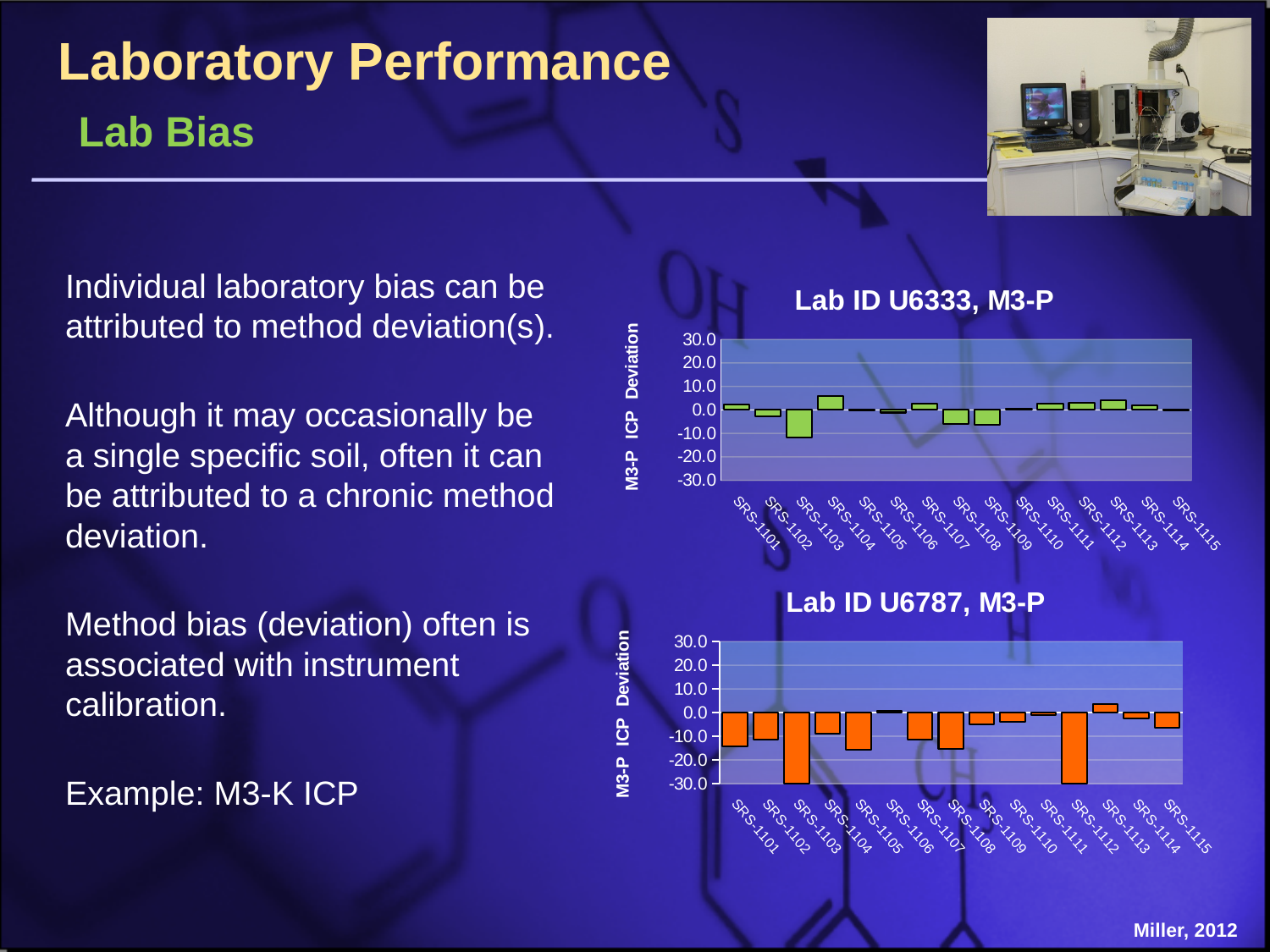
What colour are the bars in the 'Lab ID U6787, M3-P' chart? orange In the 'Lab ID U6787, M3-P' chart, is the value for SRS-1101 greater or less than 0.0? less How many categories (SRS samples) are shown on the x axis of the 'Lab ID U6787, M3-P' chart? 15 In the 'Lab ID U6333, M3-P' chart, which category has the lowest value? SRS-1103 In the 'Lab ID U6787, M3-P' chart, which category has the highest value? SRS-1113 In the 'Lab ID U6333, M3-P' chart, is the value for SRS-1104 greater or less than 0.0? greater What is the y-axis label on the 'Lab ID U6333, M3-P' chart? M3-P ICP Deviation In the 'Lab ID U6787, M3-P' chart, is the value for SRS-1103 greater or less than -20.0? less In the 'Lab ID U6333, M3-P' chart, which category has the highest value? SRS-1104 In the 'Lab ID U6787, M3-P' chart, which is larger, the value for SRS-1112 or the value for SRS-1111? SRS-1111 What kind of chart is the 'Lab ID U6333, M3-P' chart? bar chart